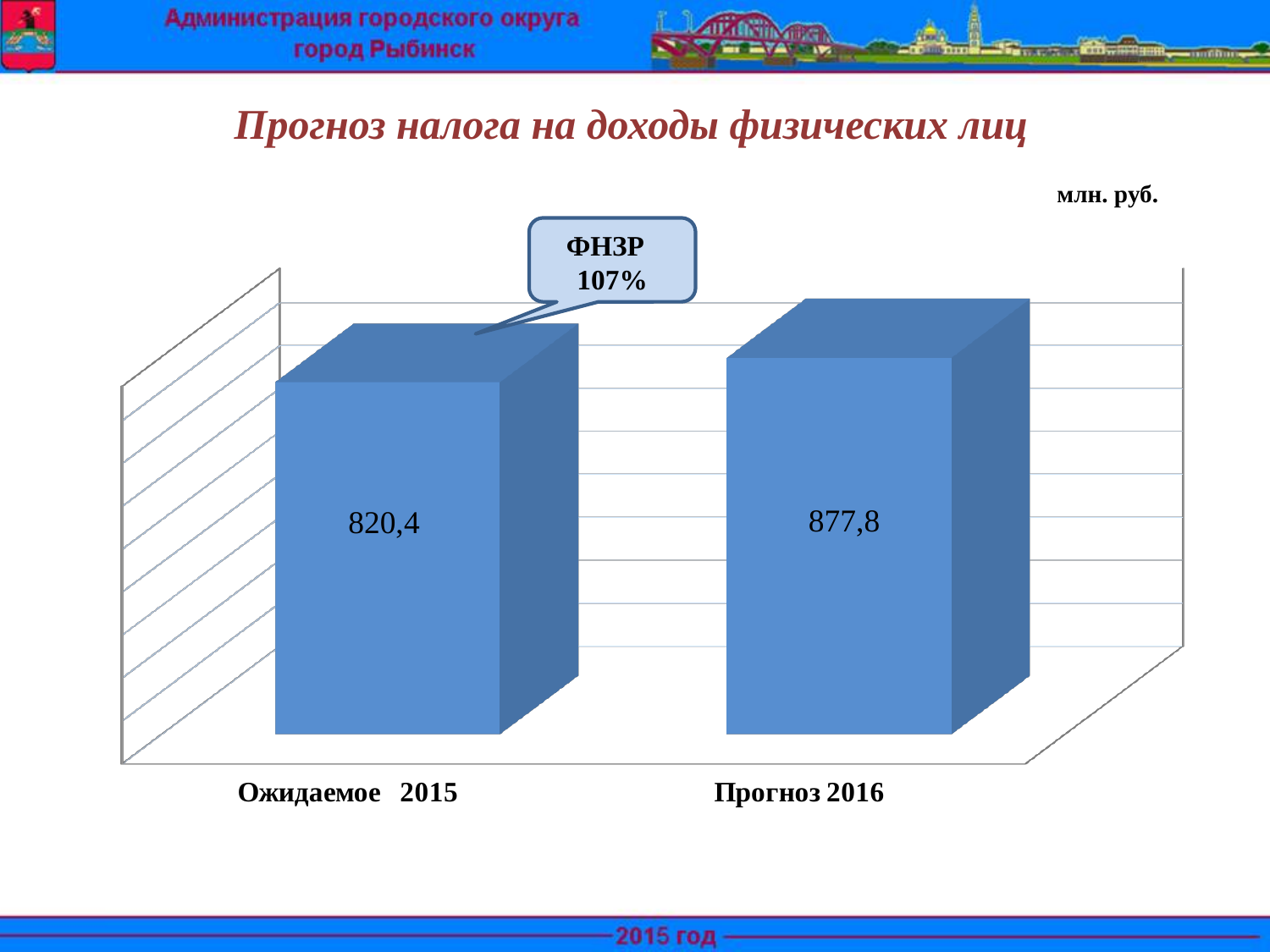
How many categories are shown in the chart? 2 What is the value for Ожидаемое 2015? 820,4 Which category has the highest value? Прогноз 2016 Which is larger, the value for Ожидаемое 2015 or the value for Прогноз 2016? Прогноз 2016 Do the values rise or fall from Ожидаемое 2015 to Прогноз 2016? rise What unit is indicated for the values in the chart? млн. руб. What is the value for Прогноз 2016? 877,8 Which category has the lowest value? Ожидаемое 2015 What kind of chart is shown on the slide? bar chart What is the title of the chart? Прогноз налога на доходы физических лиц What is the difference between the values for Прогноз 2016 and Ожидаемое 2015? 57,4